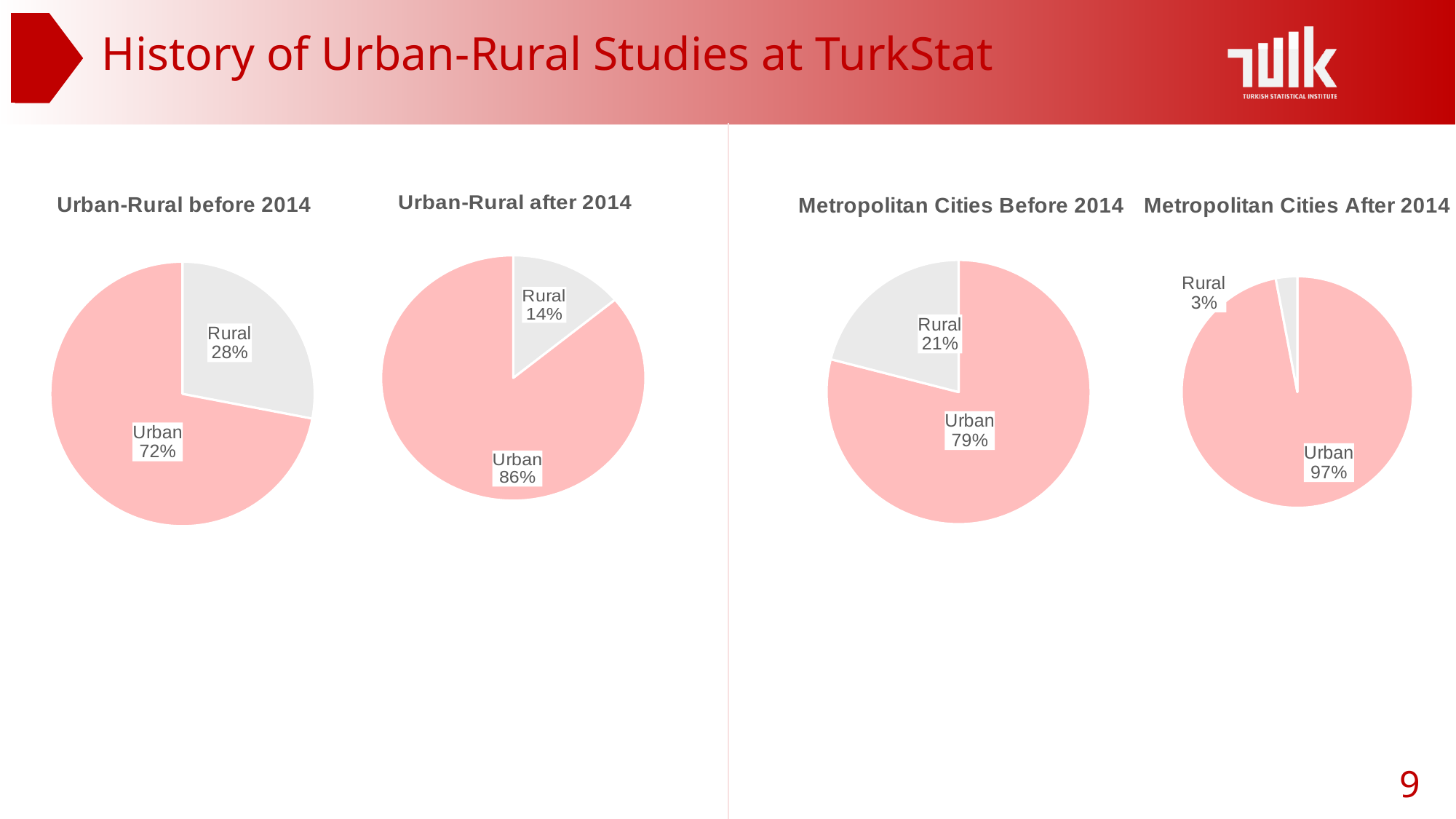
Which is larger: the Rural value in the 'Urban-Rural before 2014' chart or the Rural value in the 'Urban-Rural after 2014' chart? Urban-Rural before 2014 In the 'Urban-Rural before 2014' chart, which category has the largest slice? Urban What type of chart is 'Metropolitan Cities Before 2014'? Pie chart In the 'Metropolitan Cities After 2014' chart, what is the value for Urban? 97% In the 'Urban-Rural before 2014' chart, what is the value for Rural? 28% What is the difference between the Urban values in the 'Urban-Rural after 2014' chart and the 'Urban-Rural before 2014' chart? 14% In the 'Metropolitan Cities After 2014' chart, which category has the smallest slice? Rural What is the difference between the Rural values in the 'Metropolitan Cities Before 2014' chart and the 'Metropolitan Cities After 2014' chart? 18% In the 'Urban-Rural after 2014' chart, what is the value for Urban? 86% How many categories does the 'Urban-Rural after 2014' chart show? 2 How many pie charts are shown on the slide? 4 In the 'Metropolitan Cities Before 2014' chart, what is the value for Rural? 21%